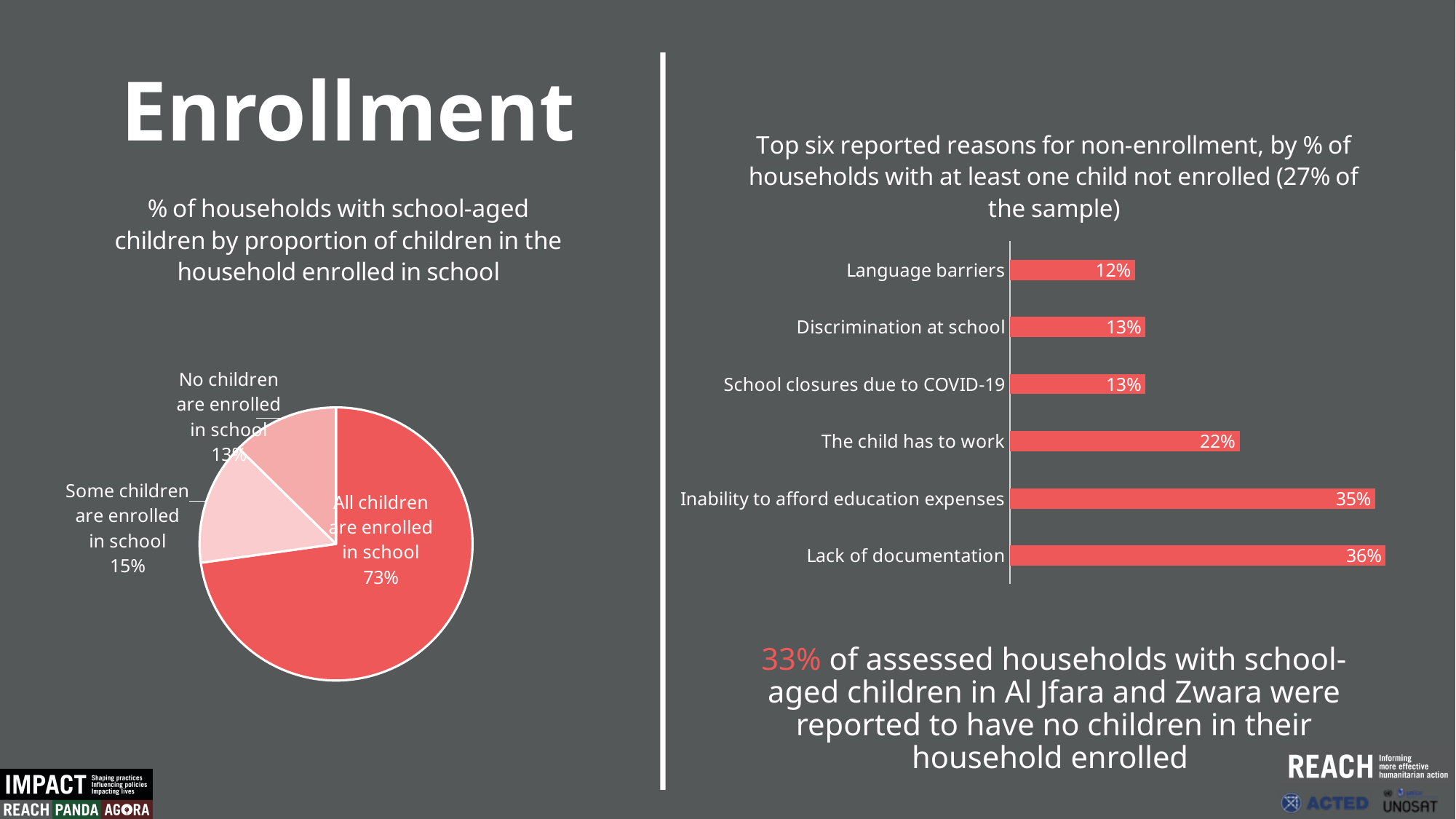
What kind of chart is shown on the left side of the slide? Pie chart In the bar chart on the right, how many reasons for non-enrollment are listed? 6 In the bar chart on the right, which reason for non-enrollment has the lowest percentage? Language barriers In the pie chart on the left, which category has the largest share? All children are enrolled in school In the pie chart on the left, what percentage of households have some children enrolled in school? 15% In the pie chart on the left, how many slices are there? 3 In the bar chart on the right, which is larger: the value for discrimination at school or the value for the child has to work? The child has to work In the bar chart on the right, what is the difference between the percentages for inability to afford education expenses and the child has to work? 13% In the pie chart on the left, what percentage of households have all children enrolled in school? 73% In the bar chart on the right, what percentage of households reported that the child has to work? 22% What kind of chart is shown on the right side of the slide? Bar chart In the bar chart on the right, what percentage of households reported lack of documentation as a reason for non-enrollment? 36%